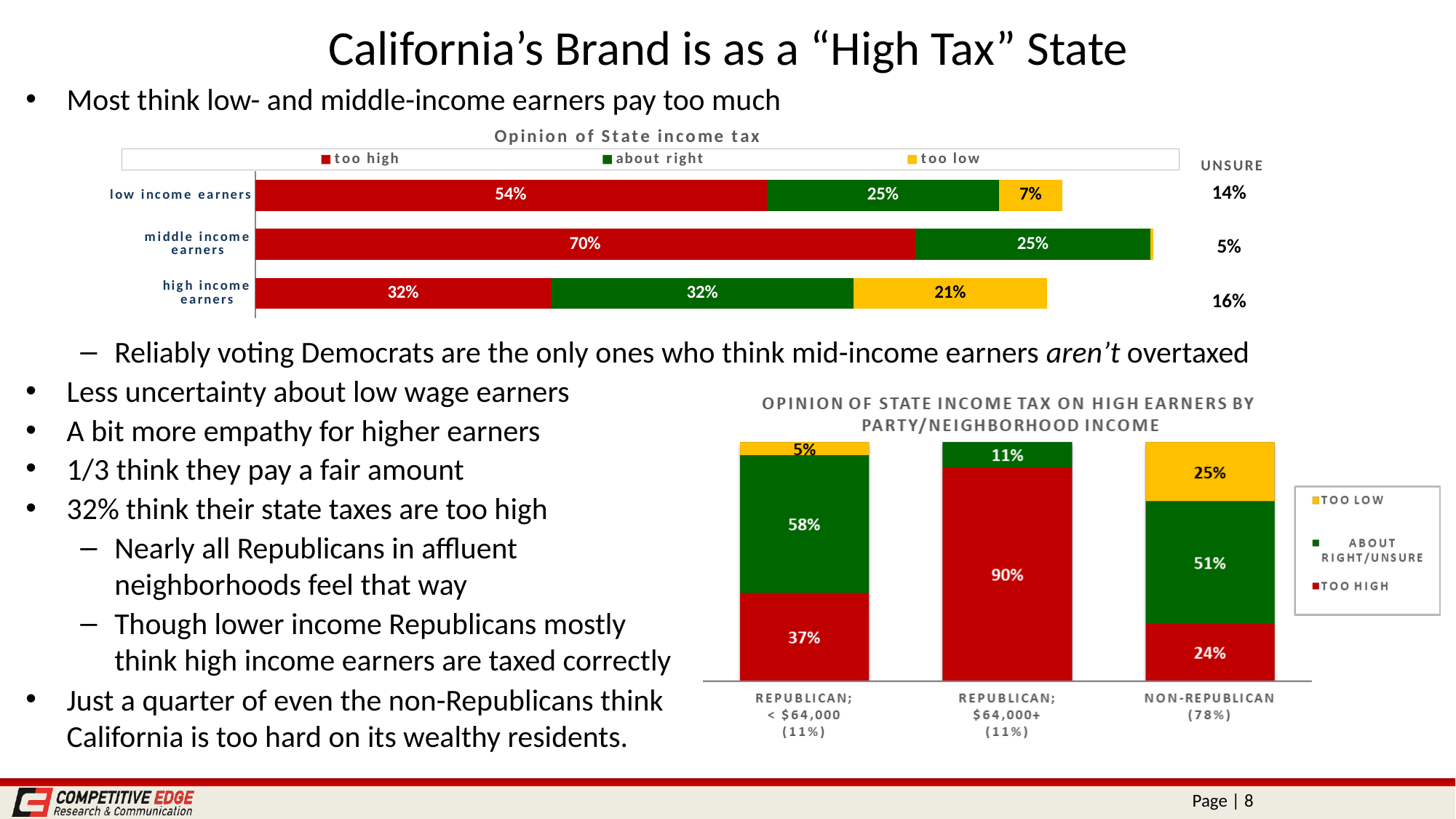
In the 'Opinion of State income tax' chart, what is the unsure value for high income earners? 16% How many series does the legend of the 'Opinion of State income tax' chart list? 3 In the 'Opinion of State income tax' chart, what is the 'too low' value for high income earners? 21% In the chart on high earners by party/neighborhood income, what percentage of Republicans earning $64,000+ say taxes on high earners are too high? 90% What kind of chart is the 'Opinion of State income tax' chart? stacked bar chart In the 'Opinion of State income tax' chart, which income group has the highest 'too high' share? middle income earners In the chart on high earners by party/neighborhood income, is the 'too high' value larger for Republicans under $64,000 or for non-Republicans? Republicans under $64,000 In the chart on high earners by party/neighborhood income, which group has the lowest 'too high' value? Non-Republican In the 'Opinion of State income tax' chart, what is the difference between the 'too high' values for middle income earners and high income earners? 38% In the 'Opinion of State income tax' chart, what percentage say middle income earners pay too high? 70% In the chart on high earners by party/neighborhood income, what is the 'too low' value for non-Republicans? 25% In the 'Opinion of State income tax' chart, what percentage say low income earners pay too high? 54%